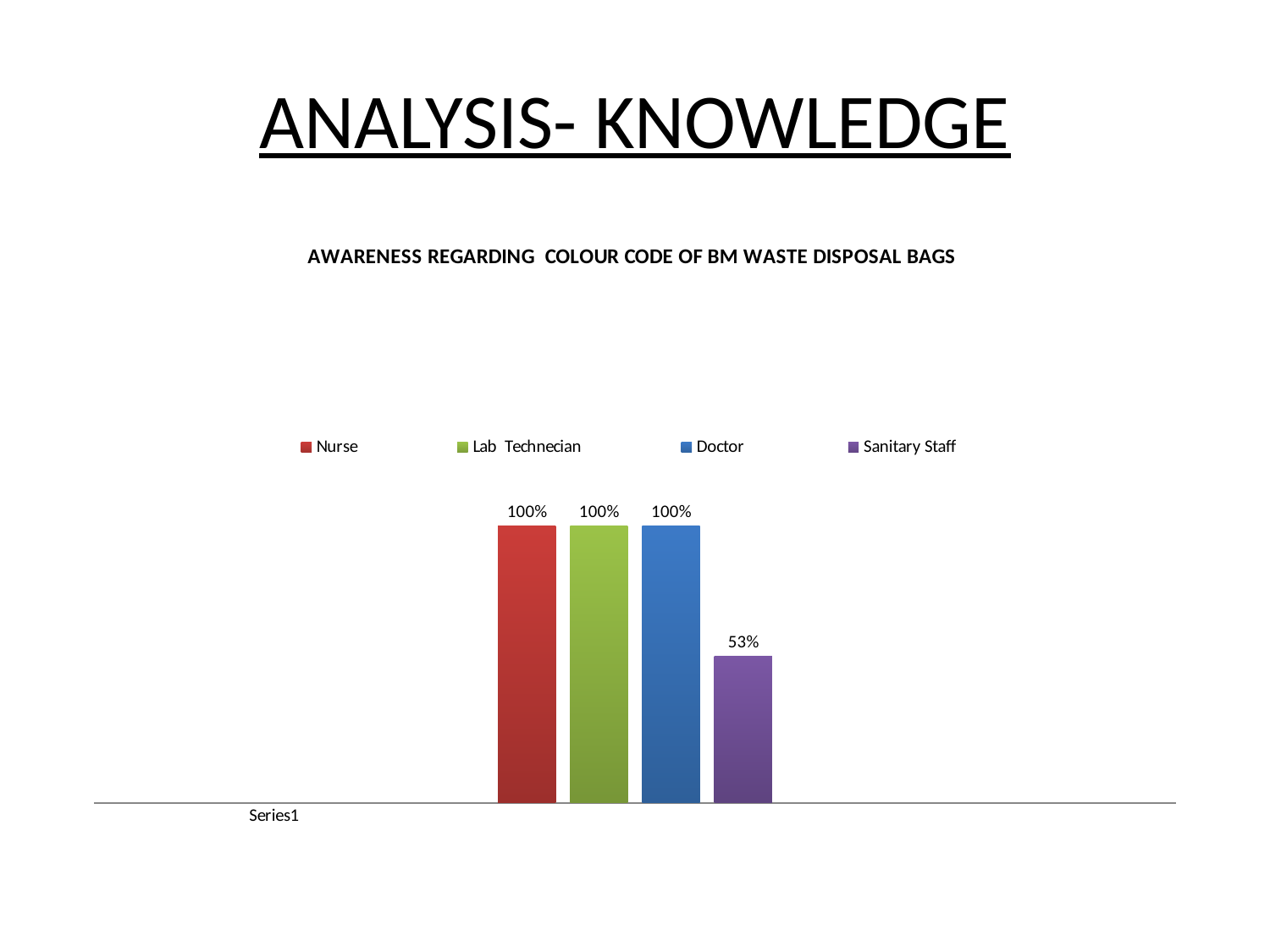
What is the value for Sanitary Staff? 53% What colour is the bar for Sanitary Staff? Purple What is the value for Lab Technecian? 100% What kind of chart is shown on the slide? Bar chart What is the value for Doctor? 100% How many bars are plotted in the chart? 4 What is the title of the chart? AWARENESS REGARDING COLOUR CODE OF BM WASTE DISPOSAL BAGS Which is larger, the value for Doctor or the value for Sanitary Staff? Doctor What is the difference between the values for Nurse and Sanitary Staff? 47% Which group has the lowest value? Sanitary Staff What is the value for Nurse? 100% How many series does the legend list? 4